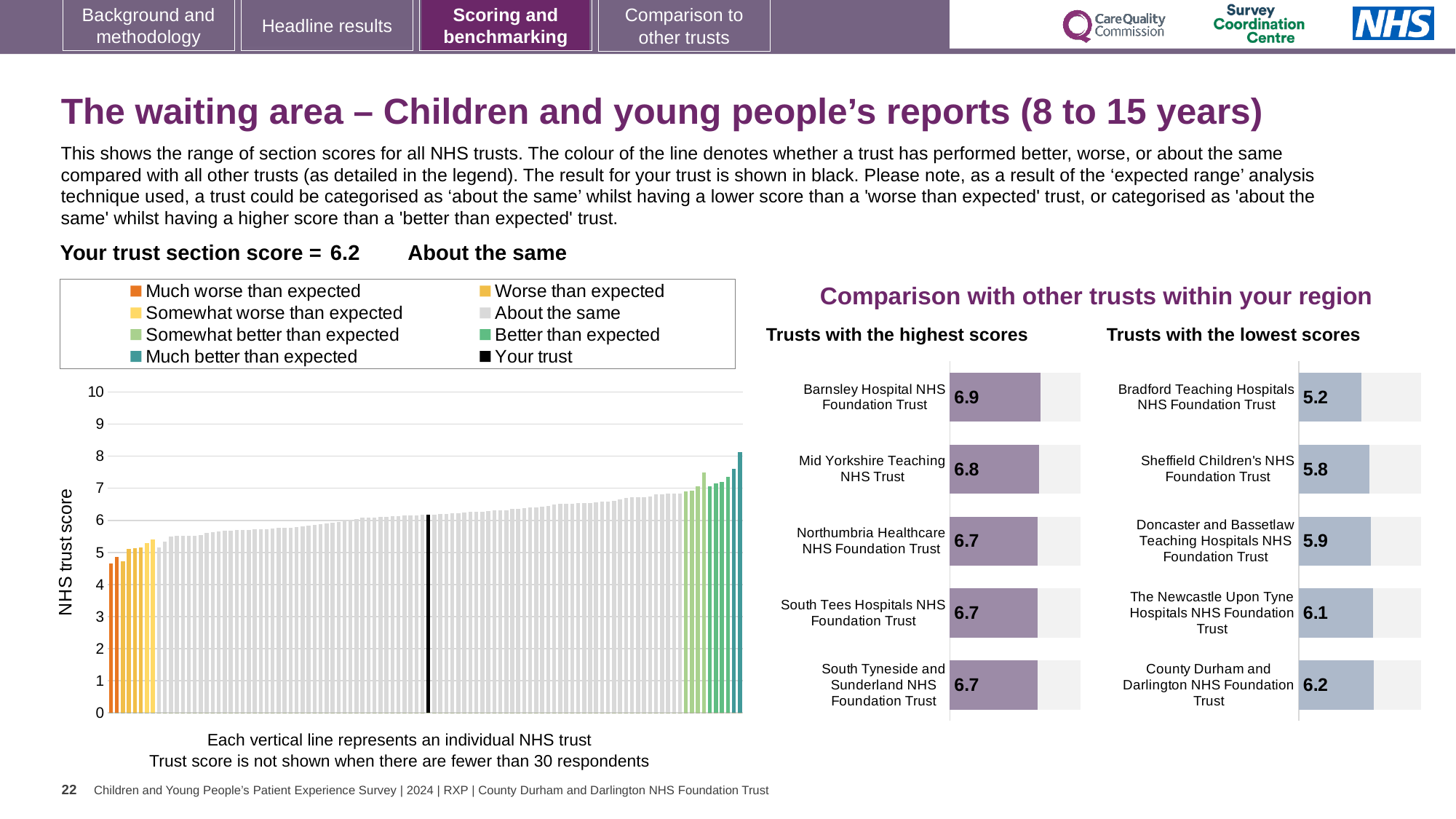
In the 'Trusts with the highest scores' chart, which trust has the highest score? Barnsley Hospital NHS Foundation Trust In the large chart on the left showing all NHS trusts, what is the score for your trust (the black bar)? 6.2 How many trusts are shown in the 'Trusts with the highest scores' chart? 5 In the large chart on the left showing all NHS trusts, is the value of the lowest (leftmost) bar greater or less than 5? less In the 'Trusts with the lowest scores' chart, which trust has the lowest score? Bradford Teaching Hospitals NHS Foundation Trust In the 'Trusts with the highest scores' chart, what is the difference between the scores of Barnsley Hospital NHS Foundation Trust and South Tees Hospitals NHS Foundation Trust? 0.2 In the 'Trusts with the lowest scores' chart, what is the score for Bradford Teaching Hospitals NHS Foundation Trust? 5.2 In the 'Trusts with the lowest scores' chart, which has the larger score: Sheffield Children's NHS Foundation Trust or The Newcastle Upon Tyne Hospitals NHS Foundation Trust? The Newcastle Upon Tyne Hospitals NHS Foundation Trust In the 'Trusts with the lowest scores' chart, what is the difference between the scores of County Durham and Darlington NHS Foundation Trust and Bradford Teaching Hospitals NHS Foundation Trust? 1.0 How many entries does the legend of the large chart on the left list? 8 In the large chart on the left showing all NHS trusts, do the bar values rise or fall from left to right? rise In the 'Trusts with the highest scores' chart, what is the score for Barnsley Hospital NHS Foundation Trust? 6.9